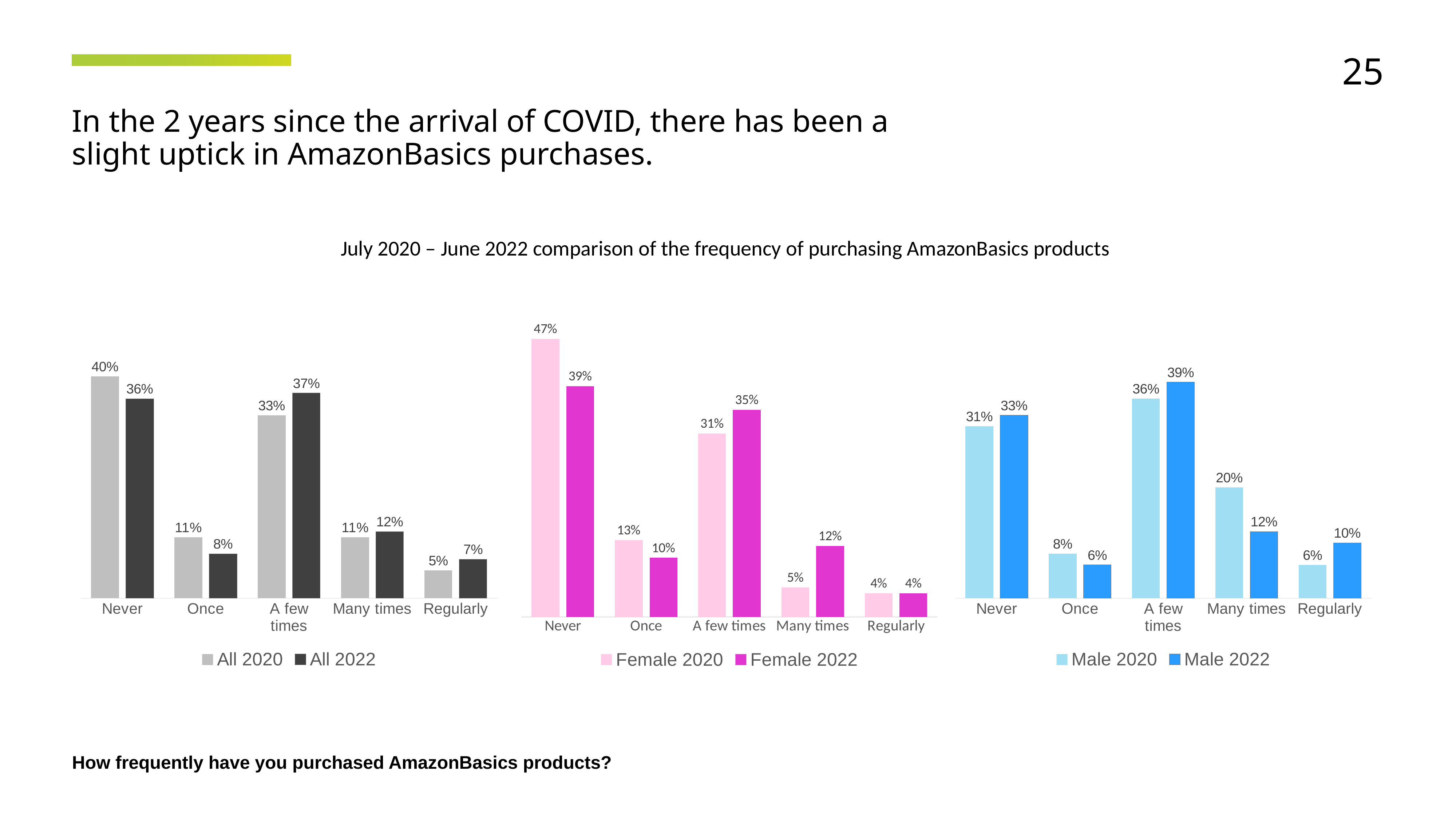
In the right chart (Male 2020 / Male 2022), which category has the highest value for Male 2022? A few times In the middle chart (Female 2020 / Female 2022), which category has the highest value for Female 2022? Never In the left chart (All 2020 / All 2022), which category has the lowest value for All 2020? Regularly In the left chart (All 2020 / All 2022), what is the difference between All 2022 and All 2020 for A few times? 4% In the middle chart (Female 2020 / Female 2022), what is the value for Never in Female 2020? 47% In the right chart (Male 2020 / Male 2022), what is the difference between Male 2020 and Male 2022 for Many times? 8% In the left chart (All 2020 / All 2022), what is the value for Never in All 2022? 36% How many series does the legend of the middle chart (Female 2020 / Female 2022) list? 2 In the middle chart (Female 2020 / Female 2022), which is larger for Many times: Female 2020 or Female 2022? Female 2022 What kind of chart is the right chart (Male 2020 / Male 2022)? Bar chart How many categories are shown on the x axis of the left chart (All 2020 / All 2022)? 5 In the right chart (Male 2020 / Male 2022), what is the value for Many times in Male 2020? 20%